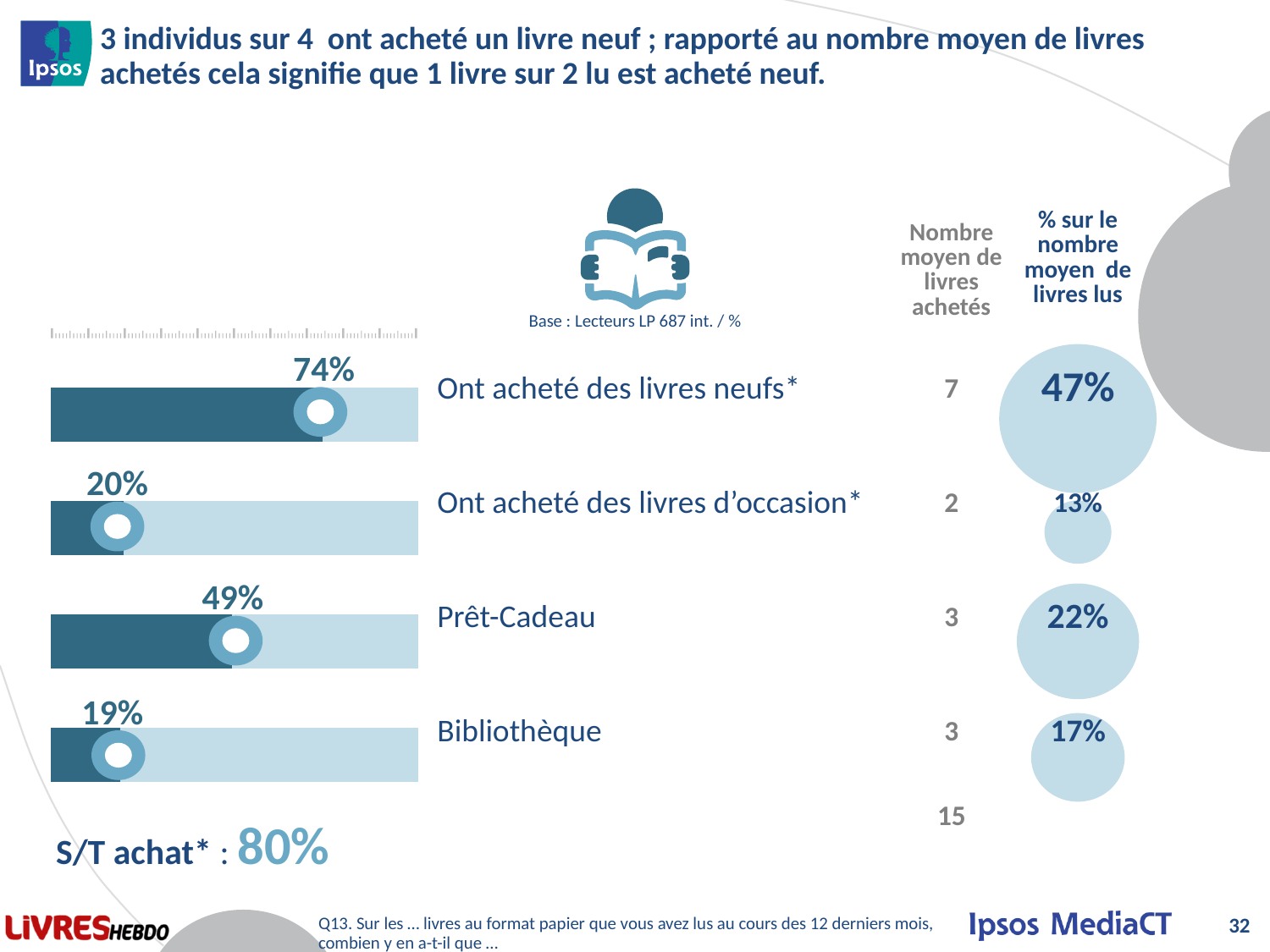
In the bar chart on the left, what is the difference between the percentages for 'Ont acheté des livres neufs*' and 'Prêt-Cadeau'? 25% In the bar chart on the left, which category has the lowest percentage? Bibliothèque In the bubble chart on the right ('% sur le nombre moyen de livres lus'), what value is shown for 'Ont acheté des livres neufs*'? 47% In the bar chart on the left, what percentage is shown for 'Ont acheté des livres neufs*'? 74% In the bubble chart on the right ('% sur le nombre moyen de livres lus'), which category has the smallest value? Ont acheté des livres d'occasion* In the bar chart on the left, which is larger: the value for 'Ont acheté des livres d'occasion*' or the value for 'Prêt-Cadeau'? Prêt-Cadeau In the bar chart on the left, what percentage is shown for 'Prêt-Cadeau'? 49% In the bar chart on the left, which category has the highest percentage? Ont acheté des livres neufs* What kind of chart is shown on the left of the slide? Bar chart In the bar chart on the left, what percentage is shown for 'Bibliothèque'? 19% What value is shown for 'S/T achat*' below the bar chart? 80% How many categories does the bar chart on the left show? 4